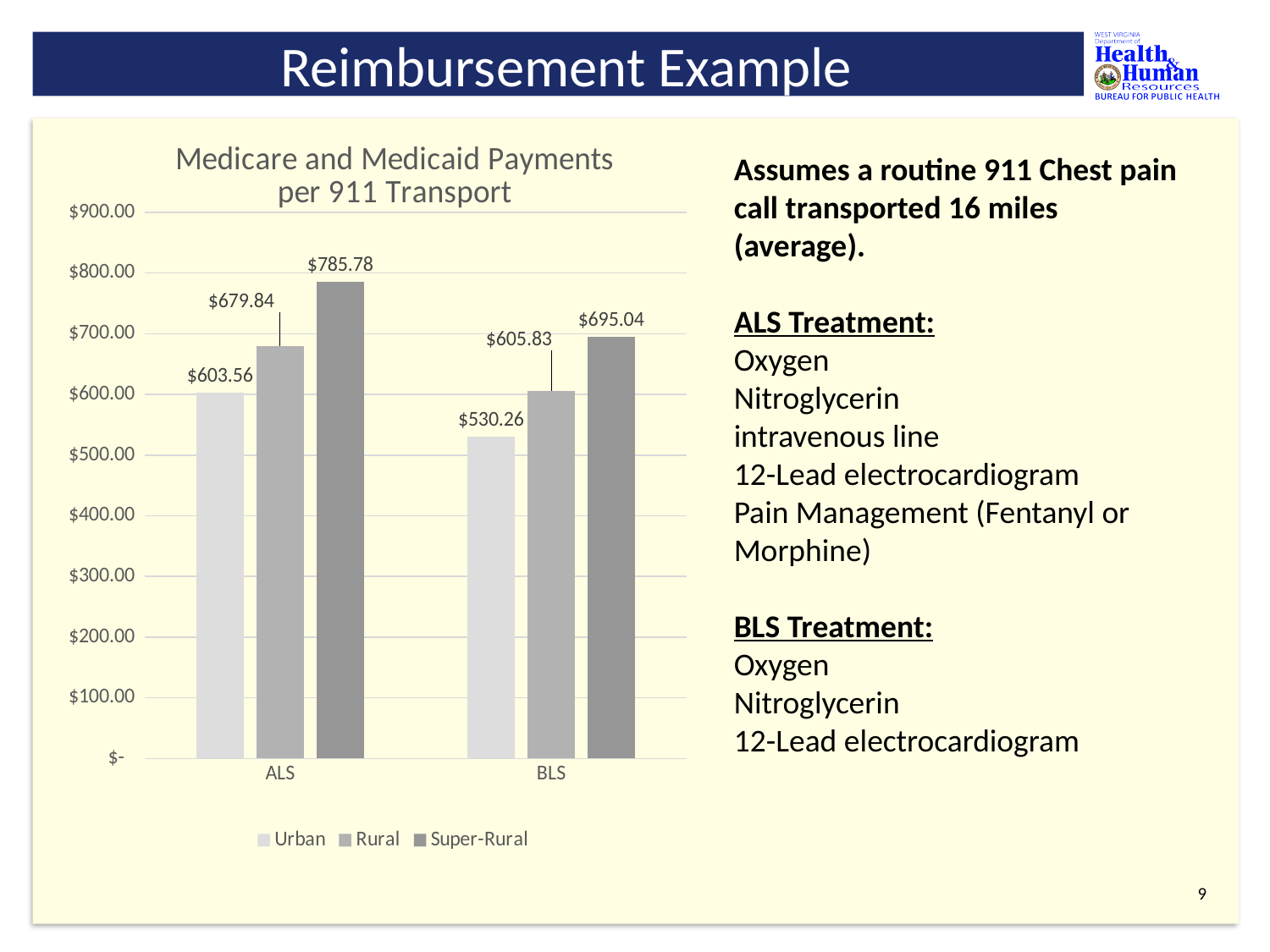
What is the Urban payment for ALS? $603.56 Which series has the highest payment for ALS? Super-Rural What is the Super-Rural payment for BLS? $695.04 What is the difference between the Urban payments for ALS and BLS? $73.30 How many series does the legend list? 3 Which bar shows the lowest payment in the chart? BLS Urban What is the Rural payment for ALS? $679.84 What is the Urban payment for BLS? $530.26 What kind of chart is shown on the slide? Bar chart What is the difference between the Super-Rural and Urban payments for ALS? $182.22 What is the title of the chart? Medicare and Medicaid Payments per 911 Transport Which is larger, the Rural payment for ALS or the Super-Rural payment for BLS? Super-Rural payment for BLS